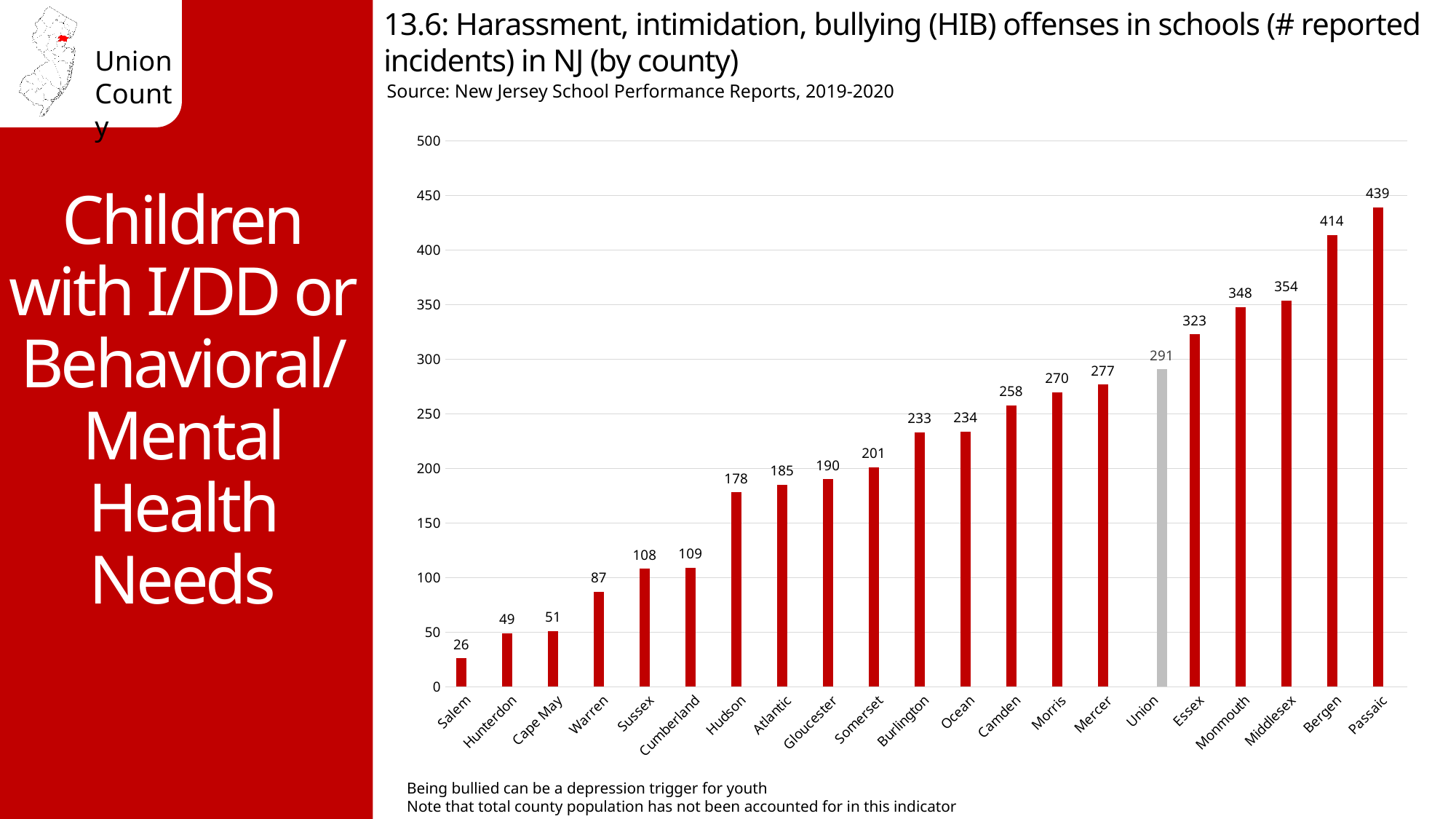
What is the number of reported HIB incidents for Union county? 291 How many counties are shown on the chart? 21 What is the difference in reported HIB incidents between Passaic and Bergen? 25 Which county has the lowest number of reported HIB incidents? Salem Do the values rise or fall moving from left to right along the x axis? Rise Which county has the highest number of reported HIB incidents? Passaic Is the value for Monmouth greater or less than 300? greater What kind of chart is shown on the slide? Bar chart What is the source cited for the chart data? New Jersey School Performance Reports, 2019-2020 Which county has more reported HIB incidents, Essex or Mercer? Essex What is the number of reported HIB incidents for Hudson county? 178 Which county's bar is coloured grey instead of red? Union